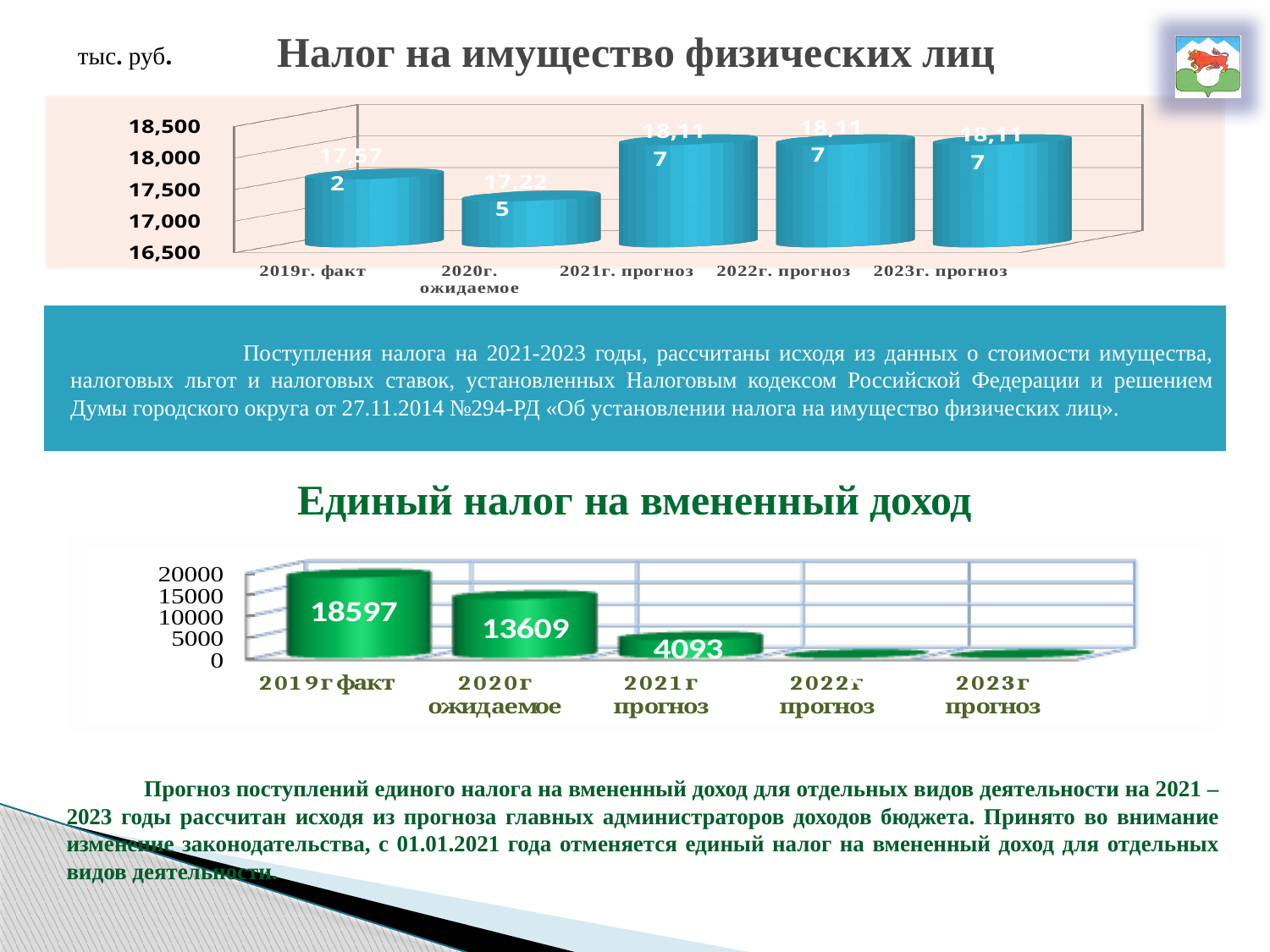
In the chart titled "Единый налог на вмененный доход", do the values rise or fall from 2019г факт to 2023г прогноз? fall In the chart titled "Налог на имущество физических лиц", how many categories are shown on the x axis? 5 In the chart titled "Налог на имущество физических лиц", which category has the lowest value? 2020г. ожидаемое In the chart titled "Единый налог на вмененный доход", what is the value for 2020г ожидаемое? 13609 In the chart titled "Налог на имущество физических лиц", is the value for 2020г. ожидаемое greater or less than 17,500? less In the chart titled "Единый налог на вмененный доход", what is the value for 2019г факт? 18597 In the chart titled "Налог на имущество физических лиц", is the value for 2021г. прогноз greater or less than 18,000? greater In the chart titled "Единый налог на вмененный доход", which category has the highest value? 2019г факт In the chart titled "Единый налог на вмененный доход", is the value for 2021г прогноз greater or less than 5000? less In the chart titled "Единый налог на вмененный доход", what is the value for 2021г прогноз? 4093 In the chart titled "Единый налог на вмененный доход", what is the difference between the values for 2019г факт and 2020г ожидаемое? 4988 What kind of chart is the chart titled "Единый налог на вмененный доход"? bar chart